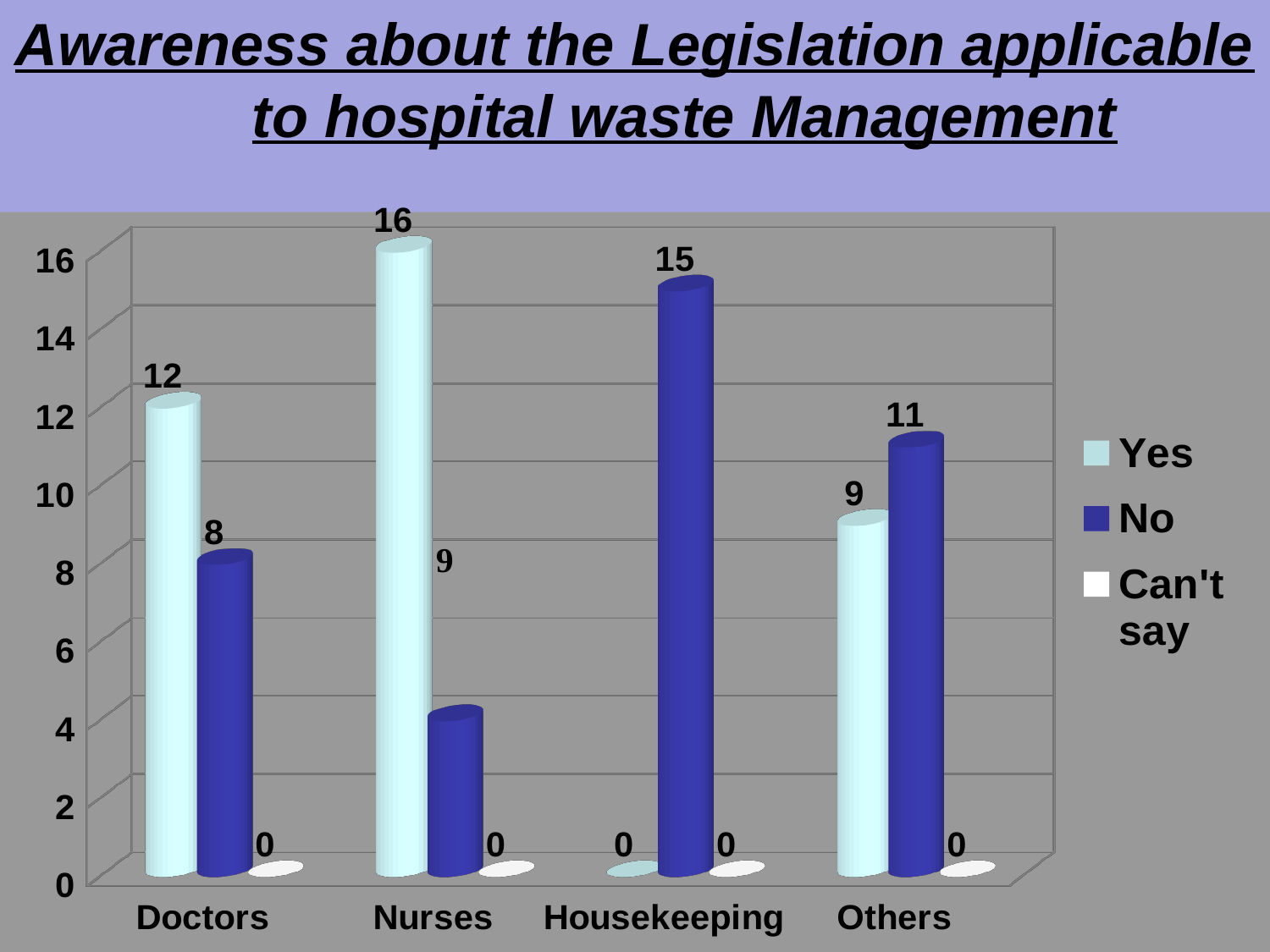
What is the value for No among Housekeeping? 15 Which category has the lowest Yes value? Housekeeping Which category has the highest Yes value? Nurses What is the difference between the Yes and No values for Doctors? 4 For Others, which is larger, the Yes value or the No value? No What is the value for No among Others? 11 How many series does the legend list? 3 What kind of chart is shown on the slide? Bar chart What is the value for Yes among Doctors? 12 How many categories are shown on the x axis? 4 What is the value for Can't say among Doctors? 0 What is the value for Yes among Nurses? 16